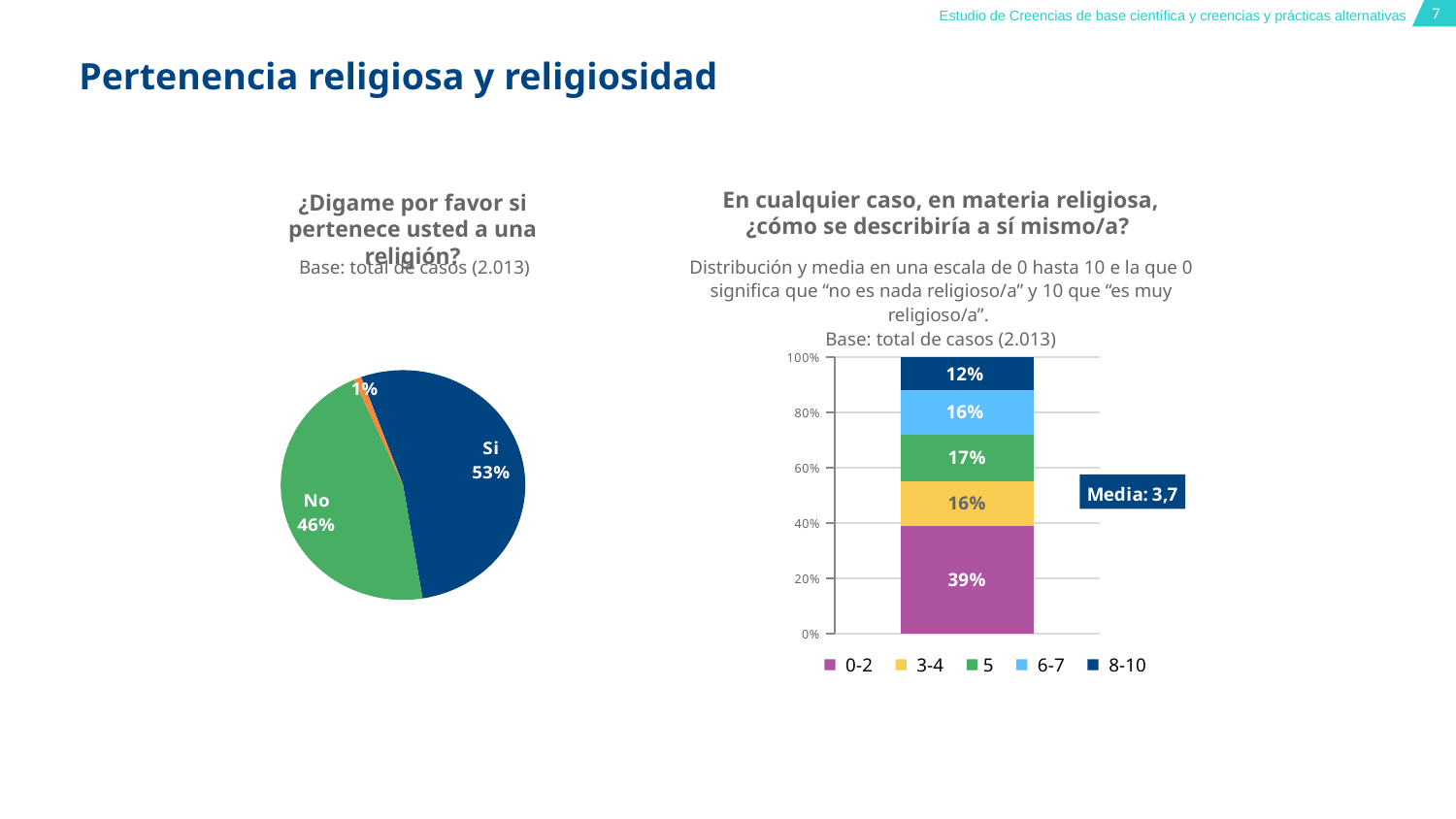
What kind of chart is shown on the left of the slide? Pie chart In the stacked bar chart on the right, what percentage corresponds to the "8-10" category? 12% In the pie chart on the left, what is the difference in percentage points between "Si" and "No"? 7 In the stacked bar chart on the right, which is larger: the share for "0-2" or the share for "3-4"? 0-2 In the pie chart on the left, what percentage of respondents answered "Si"? 53% In the pie chart on the left, what percentage of respondents answered "No"? 46% In the stacked bar chart on the right, what percentage corresponds to the "0-2" category? 39% What mean value (Media) is shown next to the stacked bar chart on the right? 3,7 How many categories does the legend of the stacked bar chart on the right list? 5 In the stacked bar chart on the right, what percentage corresponds to the "5" category? 17% In the pie chart on the left, which labelled slice is the largest? Si In the stacked bar chart on the right, which category has the smallest share? 8-10